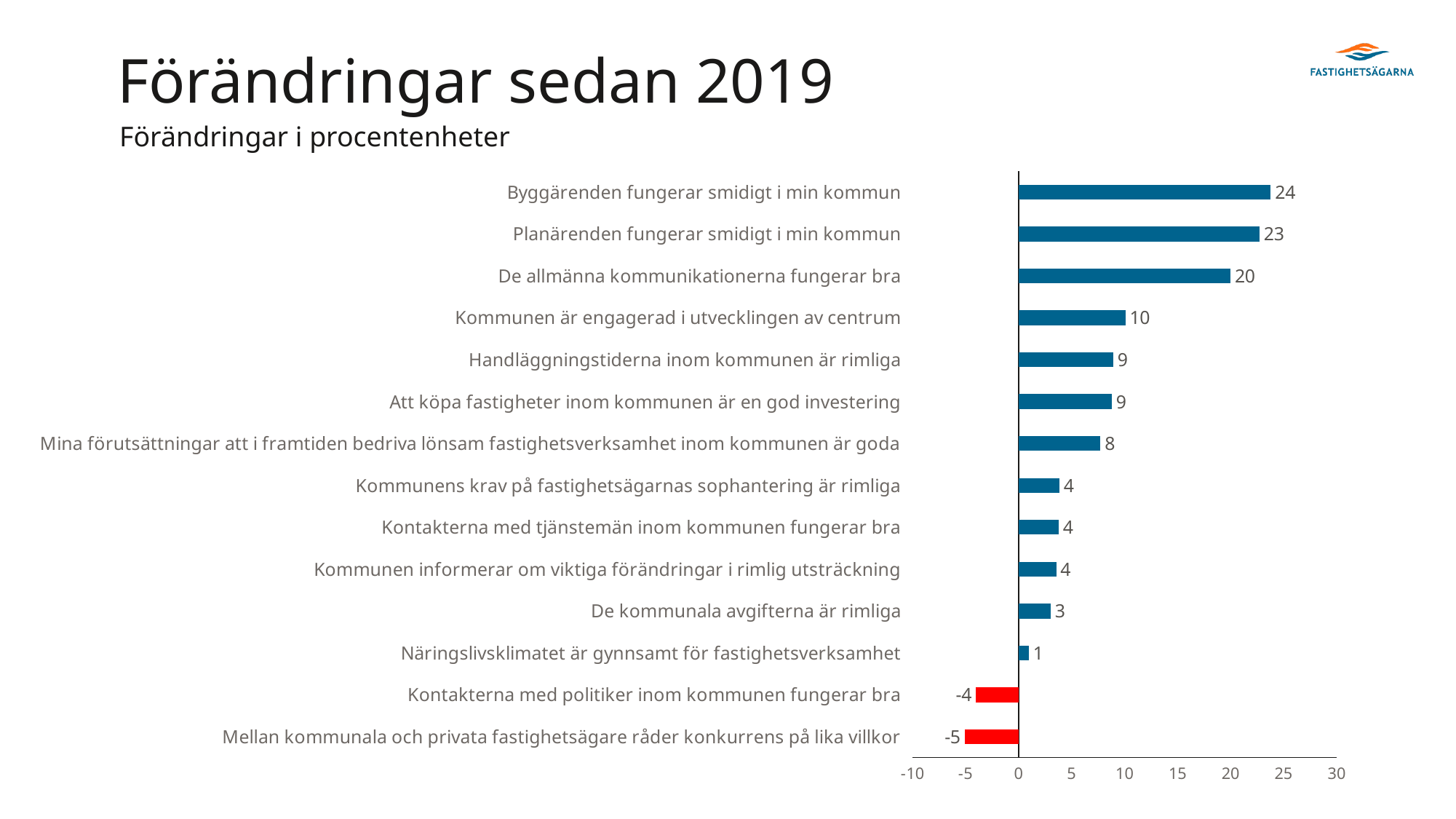
Is the value for "De allmänna kommunikationerna fungerar bra" greater or less than 15? greater Which category has the highest value? Byggärenden fungerar smidigt i min kommun What is the value for "De allmänna kommunikationerna fungerar bra"? 20 What kind of chart is shown on the slide? Bar chart What is the value for "Byggärenden fungerar smidigt i min kommun"? 24 What is the value for "Näringslivsklimatet är gynnsamt för fastighetsverksamhet"? 1 What is the difference between the values for "Planärenden fungerar smidigt i min kommun" and "Kommunen är engagerad i utvecklingen av centrum"? 13 How many categories are shown in the chart? 14 Which category has the lowest value? Mellan kommunala och privata fastighetsägare råder konkurrens på lika villkor Which is larger: the value for "Mina förutsättningar att i framtiden bedriva lönsam fastighetsverksamhet inom kommunen är goda" or the value for "De kommunala avgifterna är rimliga"? Mina förutsättningar att i framtiden bedriva lönsam fastighetsverksamhet inom kommunen är goda How many bars are shown in red? 2 What is the value for "Kontakterna med politiker inom kommunen fungerar bra"? -4